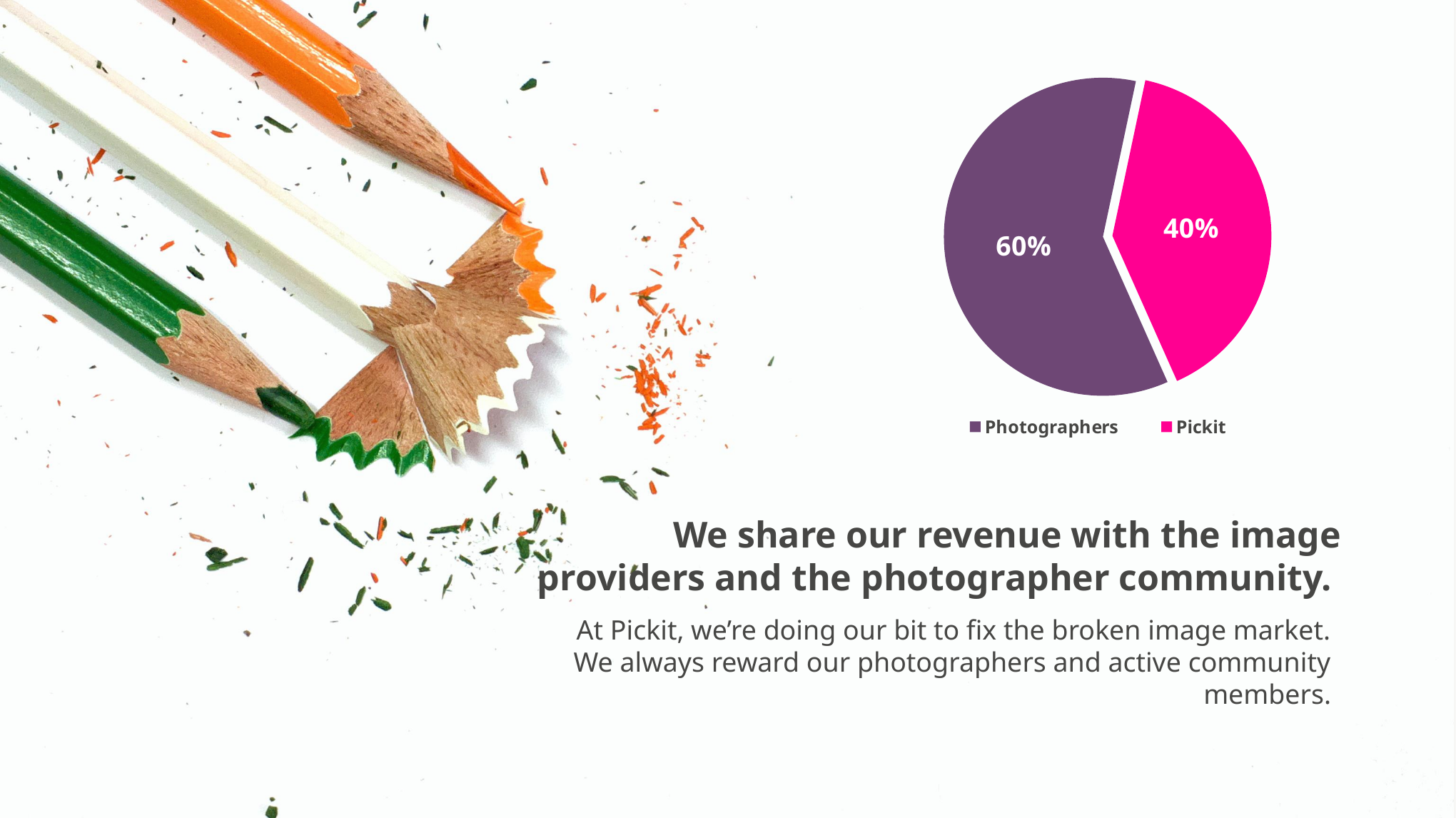
Is the Pickit share greater or less than 50%? less What kind of chart is shown on the slide? Pie chart What colour is the Pickit slice in the pie chart? Pink What share of the pie chart goes to Pickit? 40% What share of the pie chart goes to Photographers? 60% What colour is the Photographers slice in the pie chart? Purple How many entries does the legend list? 2 Which slice of the pie chart is the smallest? Pickit How many slices does the pie chart have? 2 What is the difference between the Photographers share and the Pickit share? 20% Which is larger, the Photographers share or the Pickit share? Photographers Which slice of the pie chart is the largest? Photographers